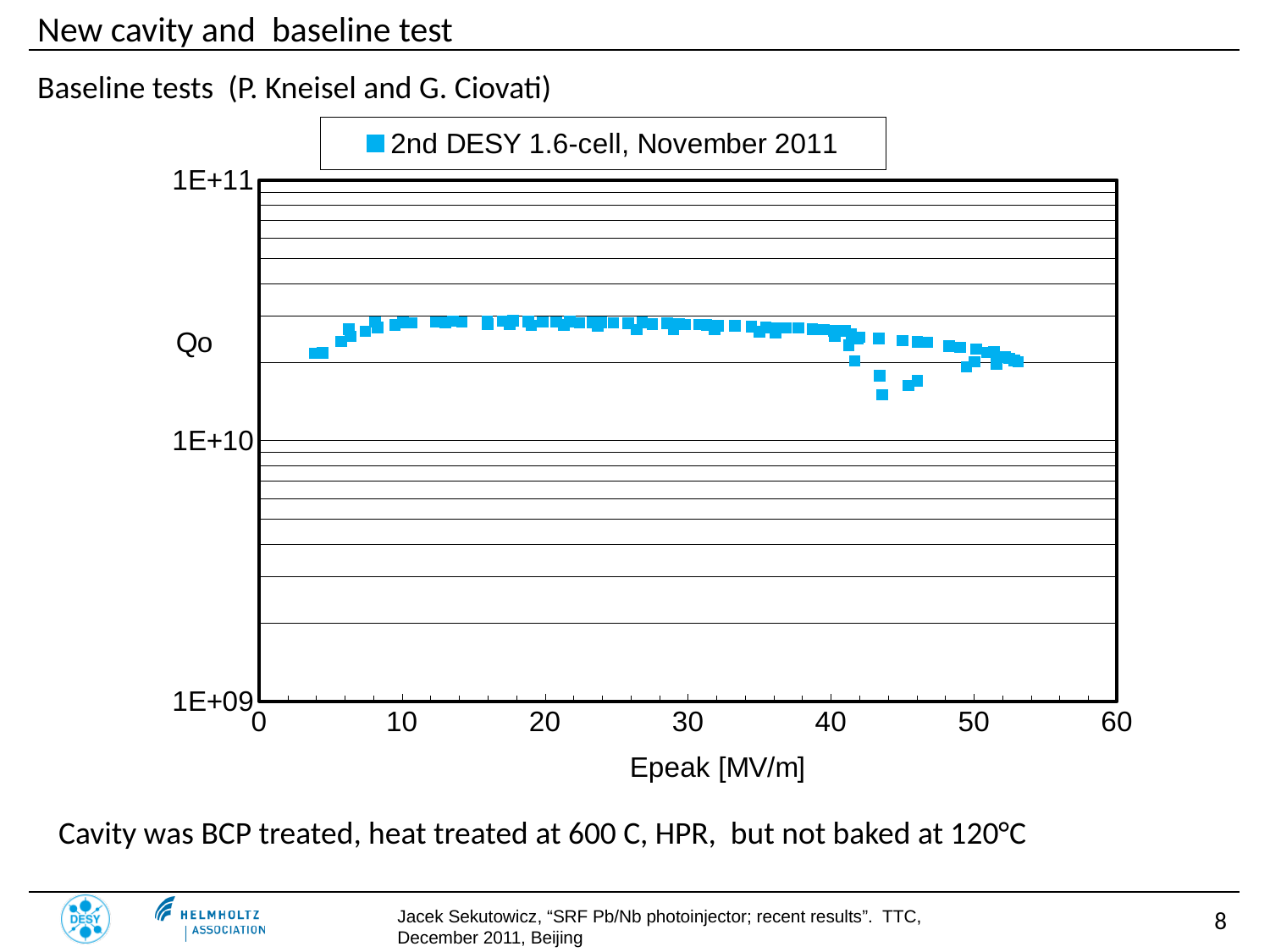
Between Epeak 4 MV/m and 10 MV/m, does Qo rise or fall? rise What kind of chart is shown on the slide? scatter chart Is the Qo value at Epeak 20 MV/m greater or less than 1E+10? greater Is the Qo value at Epeak 20 MV/m greater or less than 1E+11? less Is the Qo value at Epeak 10 MV/m larger or smaller than the Qo value at Epeak 52 MV/m? larger Is the lowest plotted Qo value greater or less than 1E+10? greater What is the legend entry for the plotted series? 2nd DESY 1.6-cell, November 2011 Between Epeak 40 MV/m and 53 MV/m, does Qo rise or fall? fall What is the label of the x axis? Epeak [MV/m] How many series does the legend list? 1